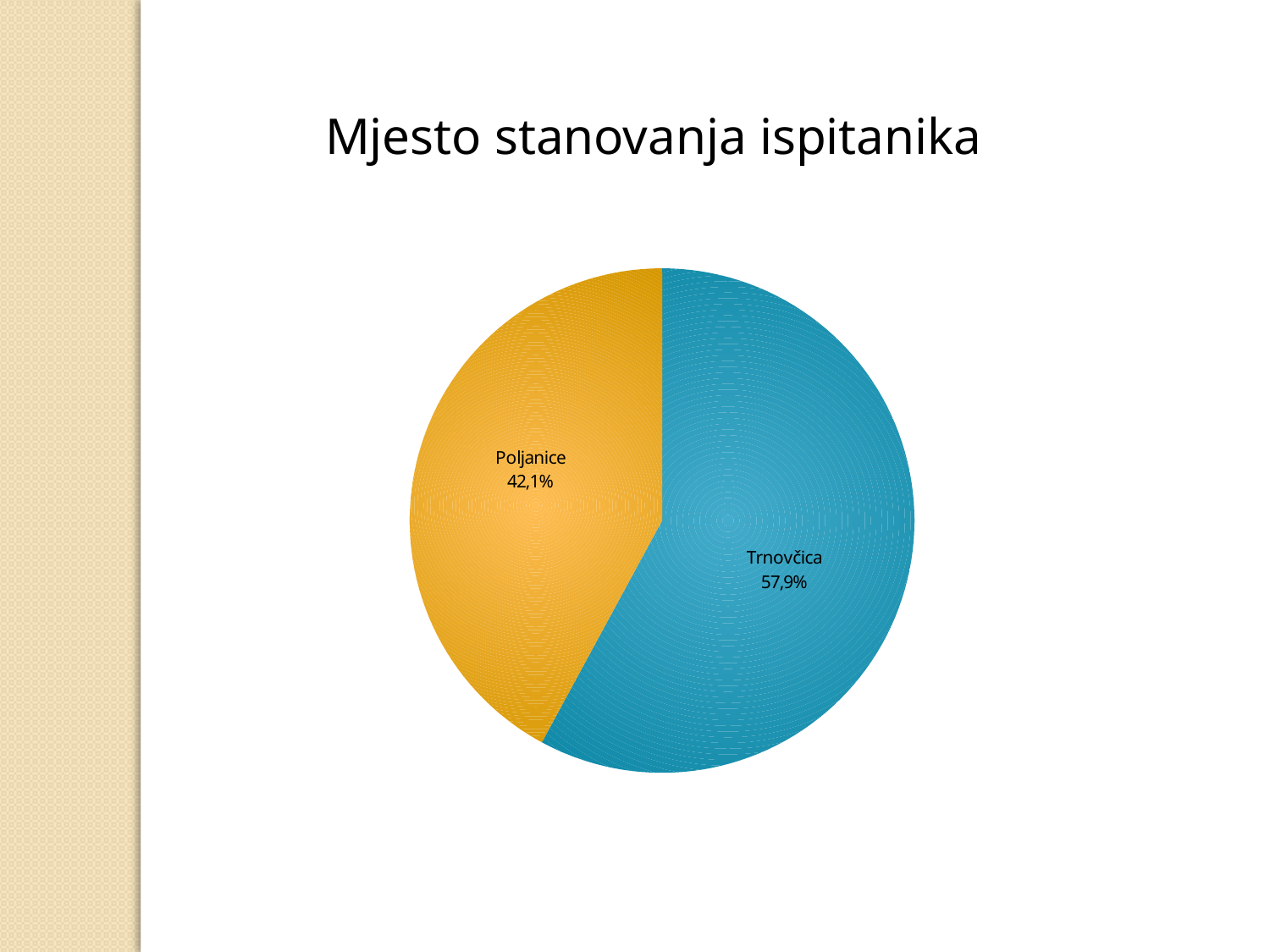
Which category has the largest slice? Trnovčica What colour is the Trnovčica slice? blue Which is larger, the slice for Poljanice or the slice for Trnovčica? Trnovčica What is the title of the chart? Mjesto stanovanja ispitanika What is the difference in percentage points between the Trnovčica and Poljanice slices? 15,8 How many slices does the pie chart have? 2 Which category has the smallest slice? Poljanice What kind of chart is shown on the slide? pie chart What share of the pie does Poljanice have? 42,1% What share of the pie does Trnovčica have? 57,9%